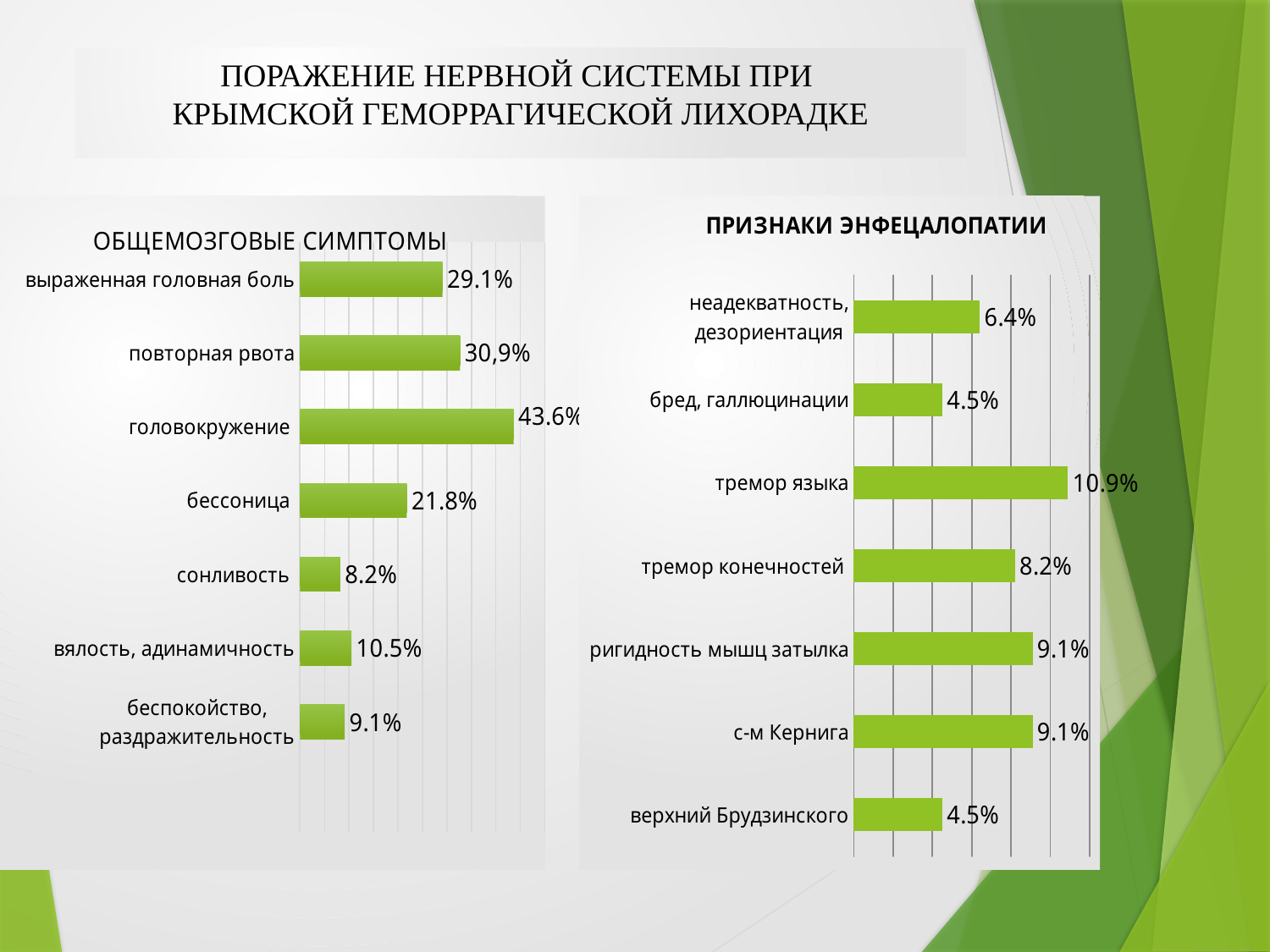
In the chart titled ОБЩЕМОЗГОВЫЕ СИМПТОМЫ, what is the value for бессоница? 21.8% What kind of chart is the chart titled ПРИЗНАКИ ЭНФЕЦАЛОПАТИИ? Bar chart In the chart titled ПРИЗНАКИ ЭНФЕЦАЛОПАТИИ, which category has the highest value? тремор языка In the chart titled ПРИЗНАКИ ЭНФЕЦАЛОПАТИИ, which is larger: the value for тремор конечностей or the value for бред, галлюцинации? тремор конечностей In the chart titled ОБЩЕМОЗГОВЫЕ СИМПТОМЫ, which category has the highest value? головокружение In the chart titled ОБЩЕМОЗГОВЫЕ СИМПТОМЫ, what is the difference between the values for головокружение and выраженная головная боль? 14.5 percentage points In the chart titled ОБЩЕМОЗГОВЫЕ СИМПТОМЫ, which category has the lowest value? сонливость In the chart titled ПРИЗНАКИ ЭНФЕЦАЛОПАТИИ, what is the value for неадекватность, дезориентация? 6.4% In the chart titled ОБЩЕМОЗГОВЫЕ СИМПТОМЫ, how many categories are shown? 7 In the chart titled ОБЩЕМОЗГОВЫЕ СИМПТОМЫ, what is the value for головокружение? 43.6% In the chart titled ПРИЗНАКИ ЭНФЕЦАЛОПАТИИ, what is the difference between the values for тремор языка and неадекватность, дезориентация? 4.5 percentage points In the chart titled ПРИЗНАКИ ЭНФЕЦАЛОПАТИИ, what is the value for тремор языка? 10.9%